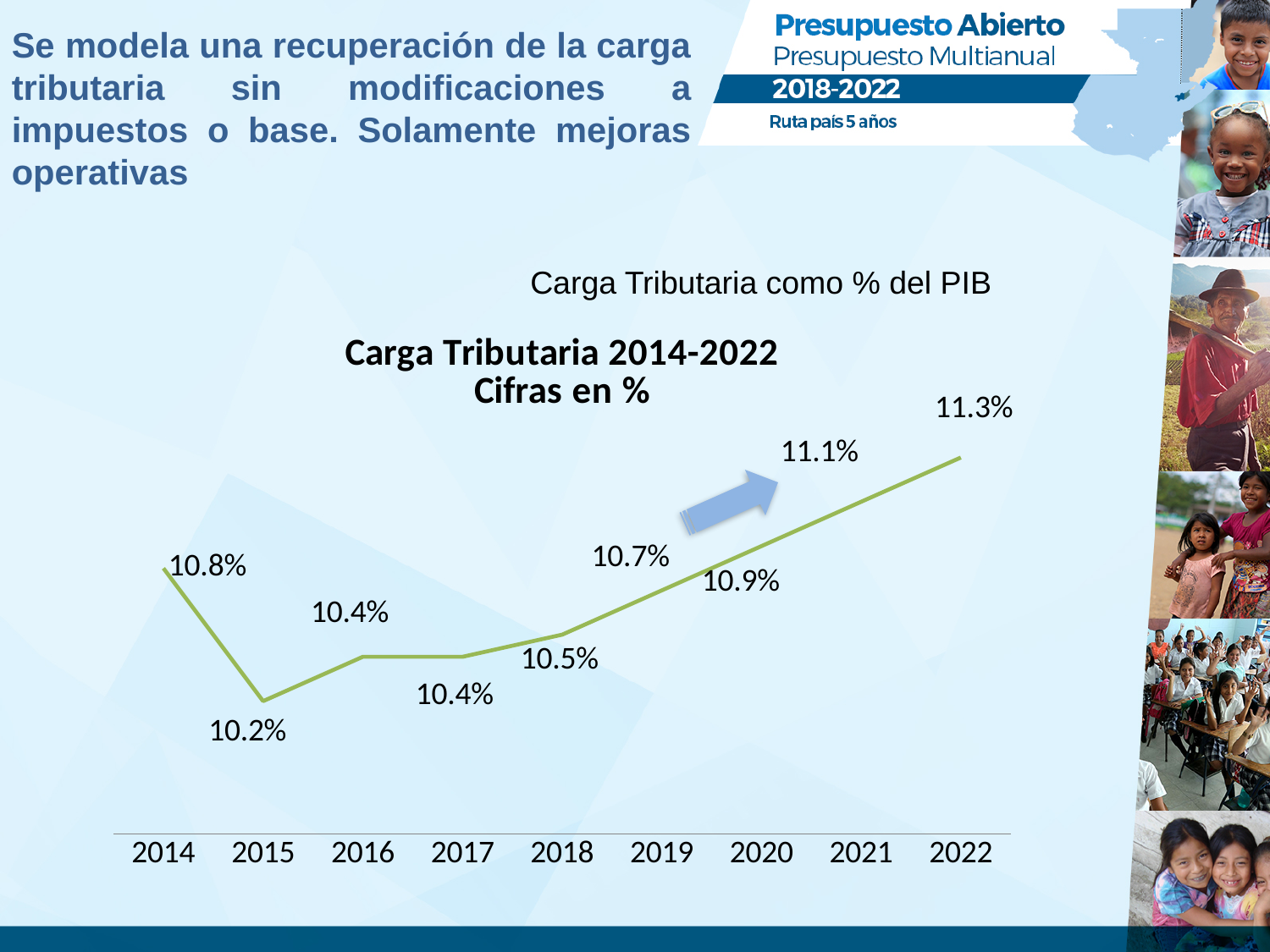
What type of chart is shown on the slide? line chart What is the value for 2015? 10.2% What is the value for 2022? 11.3% What is the difference between the values for 2022 and 2015? 1.1 percentage points What is the value for 2018? 10.5% Which year has the lowest value? 2015 What is the title of the chart? Carga Tributaria 2014-2022 Cifras en % Which is larger, the value for 2014 or the value for 2019? 2014 What is the value for 2014? 10.8% Which year has the highest value? 2022 How many years are plotted on the x axis? 9 Do the values rise or fall from 2015 to 2022? rise